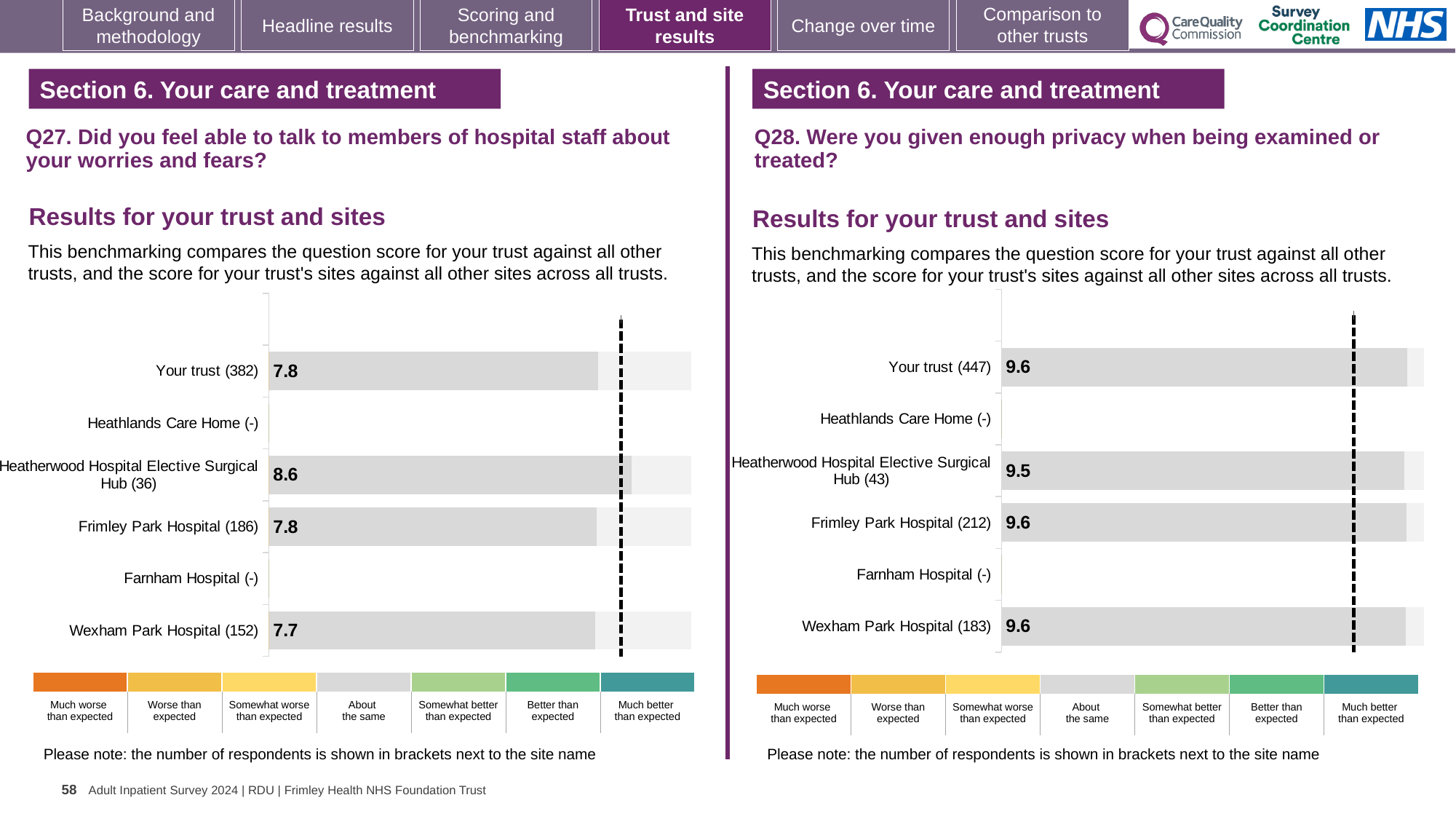
What kind of chart is used for the Q28 results on the right? Bar chart How many site rows (including Your trust) are listed in the Q27 chart on the left? 6 In the Q27 chart on the left, which site has the highest score? Heatherwood Hospital Elective Surgical Hub In the Q28 chart on the right, how many respondents are shown for Wexham Park Hospital? 183 In the Q28 chart on the right, what is the score for Your trust? 9.6 In the Q27 chart on the left, what is the difference between the scores for Heatherwood Hospital Elective Surgical Hub and Wexham Park Hospital? 0.9 In the Q27 chart on the left, what is the score for Wexham Park Hospital? 7.7 In the Q28 chart on the right, which is larger, the score for Frimley Park Hospital or Heatherwood Hospital Elective Surgical Hub? Frimley Park Hospital In the Q27 chart on the left, what is the score for Your trust? 7.8 In the Q27 chart on the left, how many respondents are shown for Frimley Park Hospital? 186 In the Q28 chart on the right, what is the score for Heatherwood Hospital Elective Surgical Hub? 9.5 In the Q27 chart on the left, what is the score for Heatherwood Hospital Elective Surgical Hub? 8.6